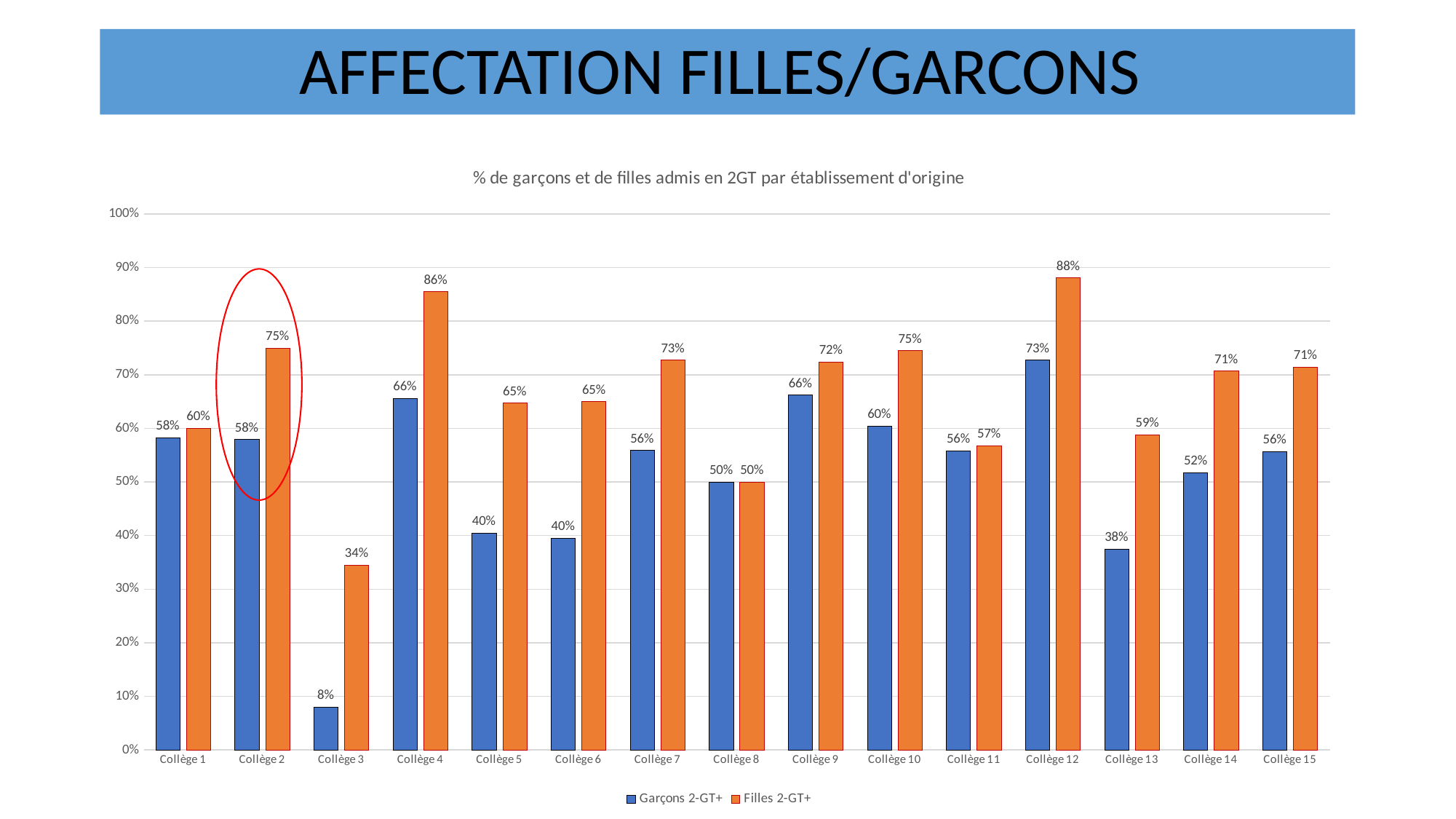
What is the value for Filles 2-GT+ at Collège 4? 86% What is the title of the chart? % de garçons et de filles admis en 2GT par établissement d'origine Which collège is circled in red on the chart? Collège 2 What is the difference between the Filles 2-GT+ and Garçons 2-GT+ values at Collège 2? 17% What is the value for Garçons 2-GT+ at Collège 13? 38% What is the value for Garçons 2-GT+ at Collège 3? 8% How many collèges are shown on the x axis? 15 Which is larger at Collège 6: the Garçons 2-GT+ value or the Filles 2-GT+ value? Filles 2-GT+ Which collège has the highest value for Filles 2-GT+? Collège 12 What kind of chart is shown on the slide? Bar chart Which collège has the lowest value for Garçons 2-GT+? Collège 3 How many series does the legend list? 2